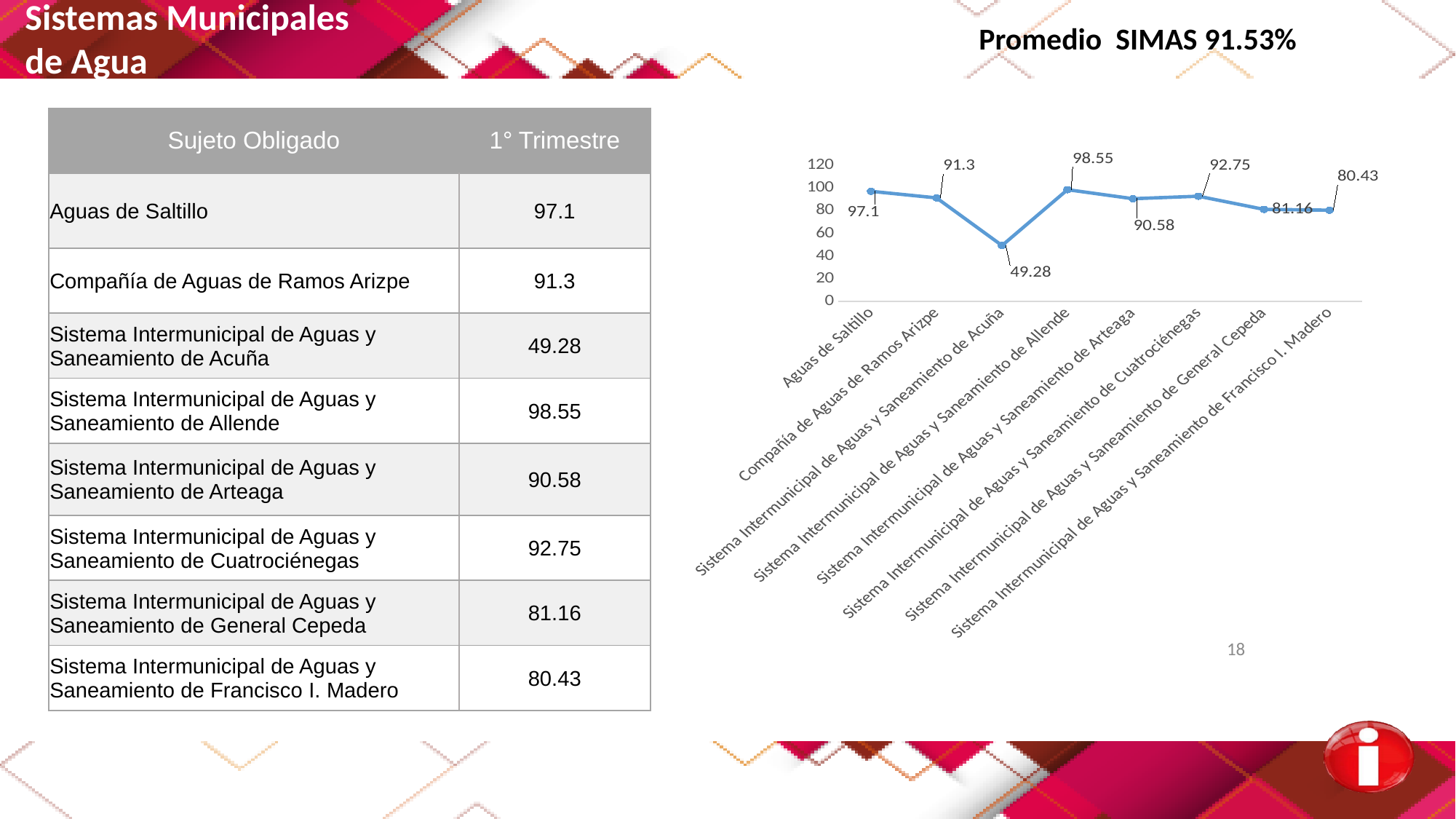
Which has a larger value, Sistema Intermunicipal de Aguas y Saneamiento de Cuatrociénegas or Sistema Intermunicipal de Aguas y Saneamiento de Arteaga? Sistema Intermunicipal de Aguas y Saneamiento de Cuatrociénegas What is the value for Sistema Intermunicipal de Aguas y Saneamiento de Acuña? 49.28 Which category has the lowest value in the line chart? Sistema Intermunicipal de Aguas y Saneamiento de Acuña Is the value for Sistema Intermunicipal de Aguas y Saneamiento de Acuña greater or less than 60? less What type of chart is shown on the slide? line chart How many data points are plotted in the line chart? 8 What is the value for Aguas de Saltillo in the line chart? 97.1 What is the difference between the values for Aguas de Saltillo and Compañía de Aguas de Ramos Arizpe? 5.8 Do the values rise or fall from Sistema Intermunicipal de Aguas y Saneamiento de Allende to Sistema Intermunicipal de Aguas y Saneamiento de Francisco I. Madero? fall What is the difference between the values for Allende (98.55) and Acuña (49.28)? 49.27 What is the value for Sistema Intermunicipal de Aguas y Saneamiento de General Cepeda? 81.16 Which category has the highest value in the line chart? Sistema Intermunicipal de Aguas y Saneamiento de Allende